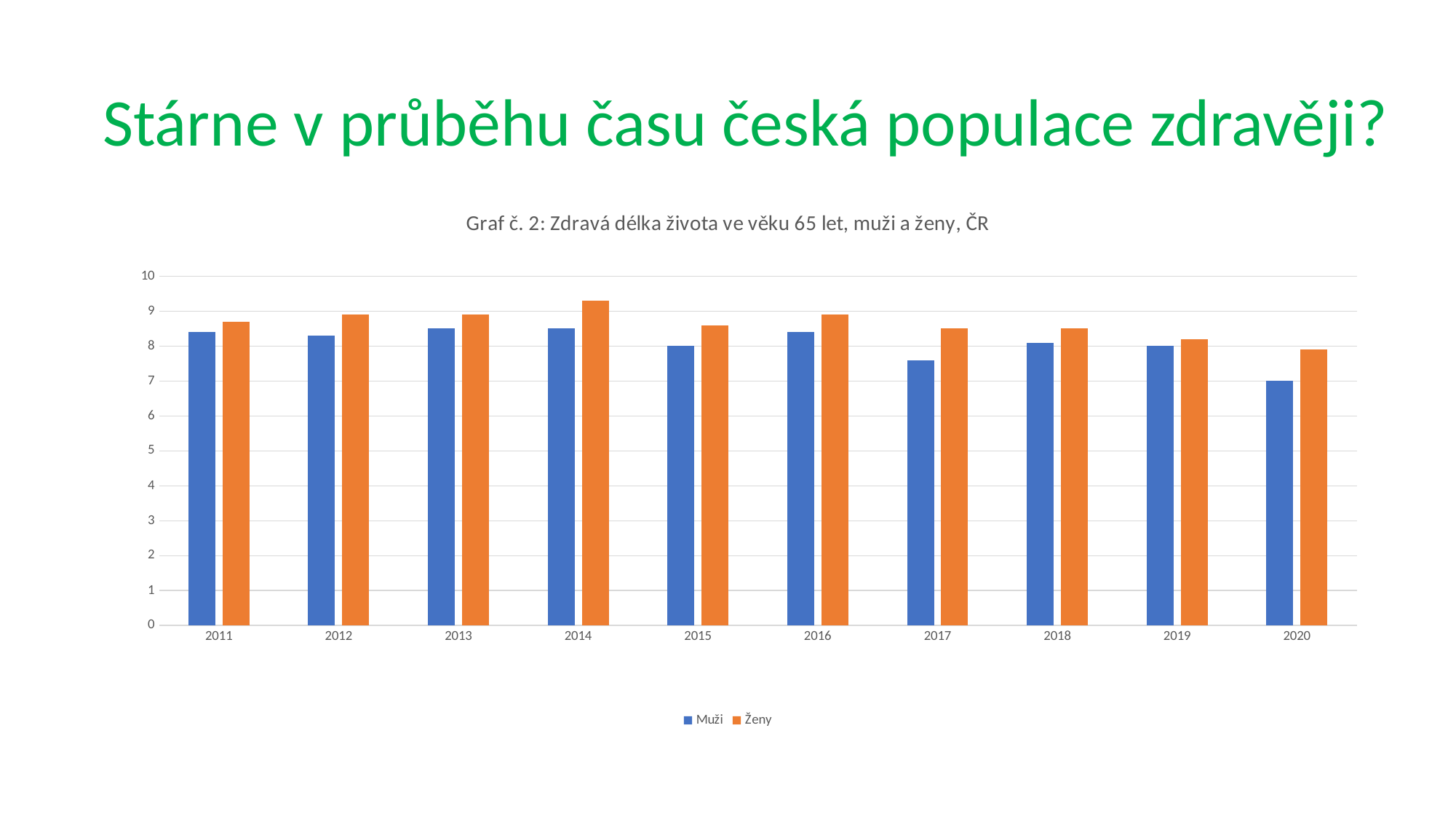
In which year is the value for Ženy the highest? 2014 In which year is the value for Muži the lowest? 2020 In 2014, which series has the larger value, Muži or Ženy? Ženy How many years are shown on the x axis of the chart? 10 Is the value for Ženy in 2014 greater or less than 9? greater Does the value for Muži generally rise or fall from 2011 to 2020? fall How many series does the legend of the chart list? 2 What is the title of the chart? Graf č. 2: Zdravá délka života ve věku 65 let, muži a ženy, ČR What kind of chart is shown on the slide? bar chart Which colour represents the Ženy series in the chart? orange Is the value for Muži in 2017 greater or less than 8? less